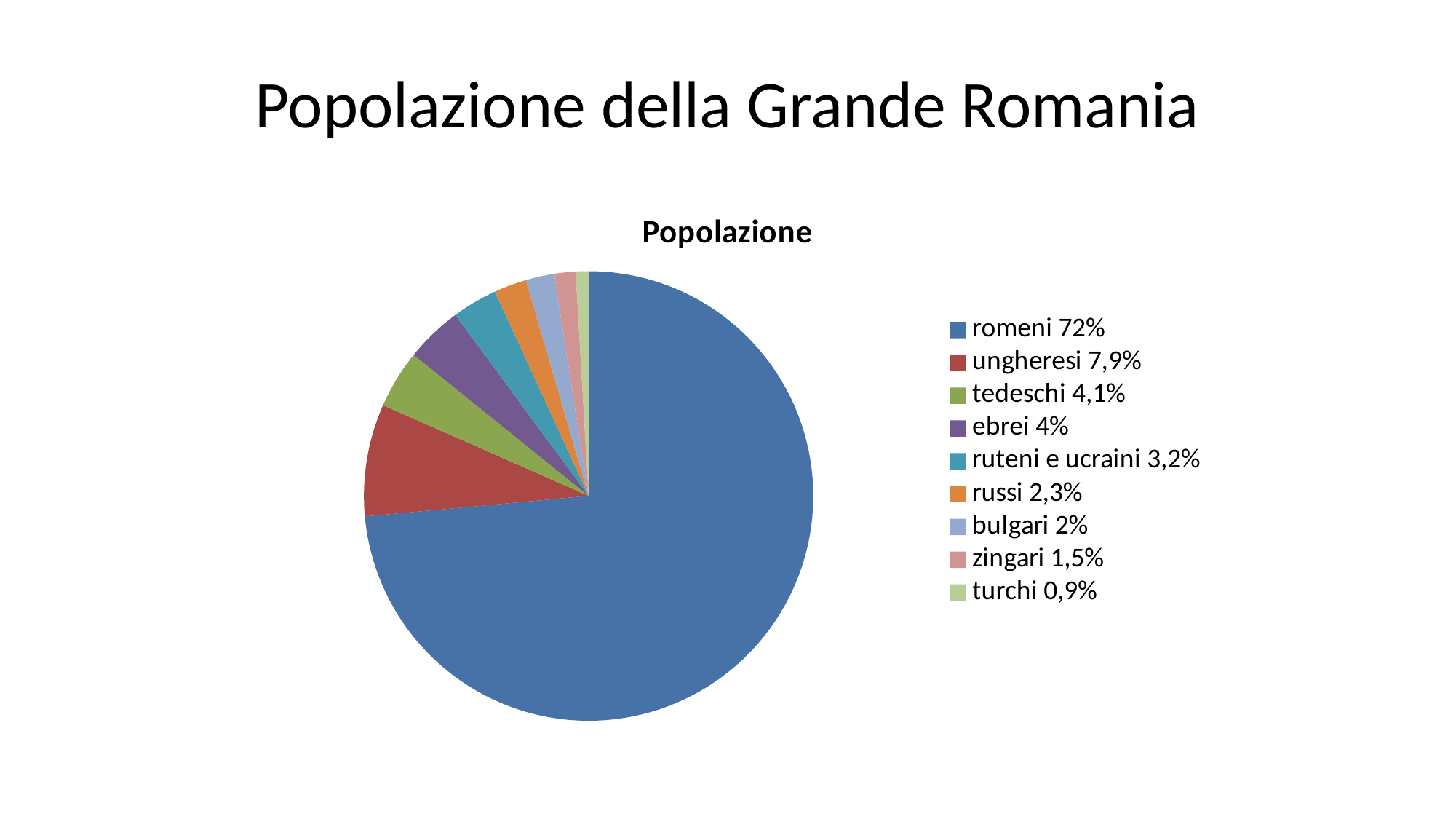
What kind of chart is shown on the slide? pie chart What is the difference between the share for ungheresi and the share for ebrei? 3,9% Which is larger, the share for tedeschi or the share for russi? tedeschi What is the chart's title? Popolazione Which category has the smallest share of the pie? turchi What share of the population is turchi? 0,9% How many categories does the pie chart have? 9 Which category has the largest share of the pie? romeni What share of the population is romeni? 72% What share of the population is ruteni e ucraini? 3,2% What colour is the slice for bulgari? light blue